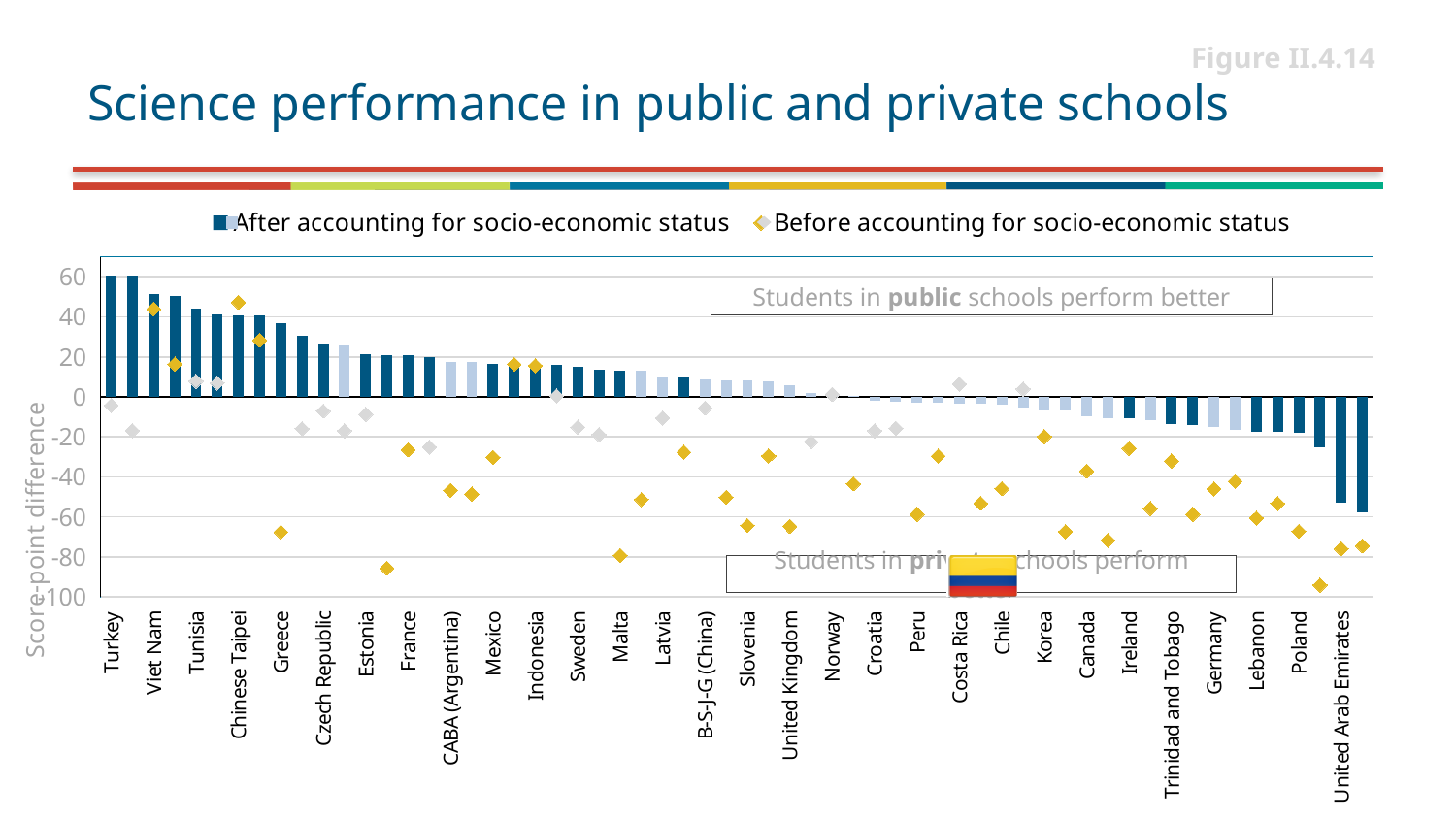
Is the 'Before accounting for socio-economic status' value for Poland greater or less than -80? greater Which labelled country has the highest bar for 'After accounting for socio-economic status'? Turkey Which has the larger 'After accounting for socio-economic status' value, Turkey or Greece? Turkey What is the title of the chart? Science performance in public and private schools Is the 'After accounting for socio-economic status' value for Turkey greater or less than 40? greater Which labelled country has the lowest bar for 'After accounting for socio-economic status'? United Arab Emirates Is the 'Before accounting for socio-economic status' value for Greece greater or less than -60? less What kind of chart is this? Combination chart with bars and diamond markers What is the label of the vertical axis? Score-point difference Do the 'After accounting for socio-economic status' bars rise or fall from left to right along the x axis? fall How many series does the legend list? 2